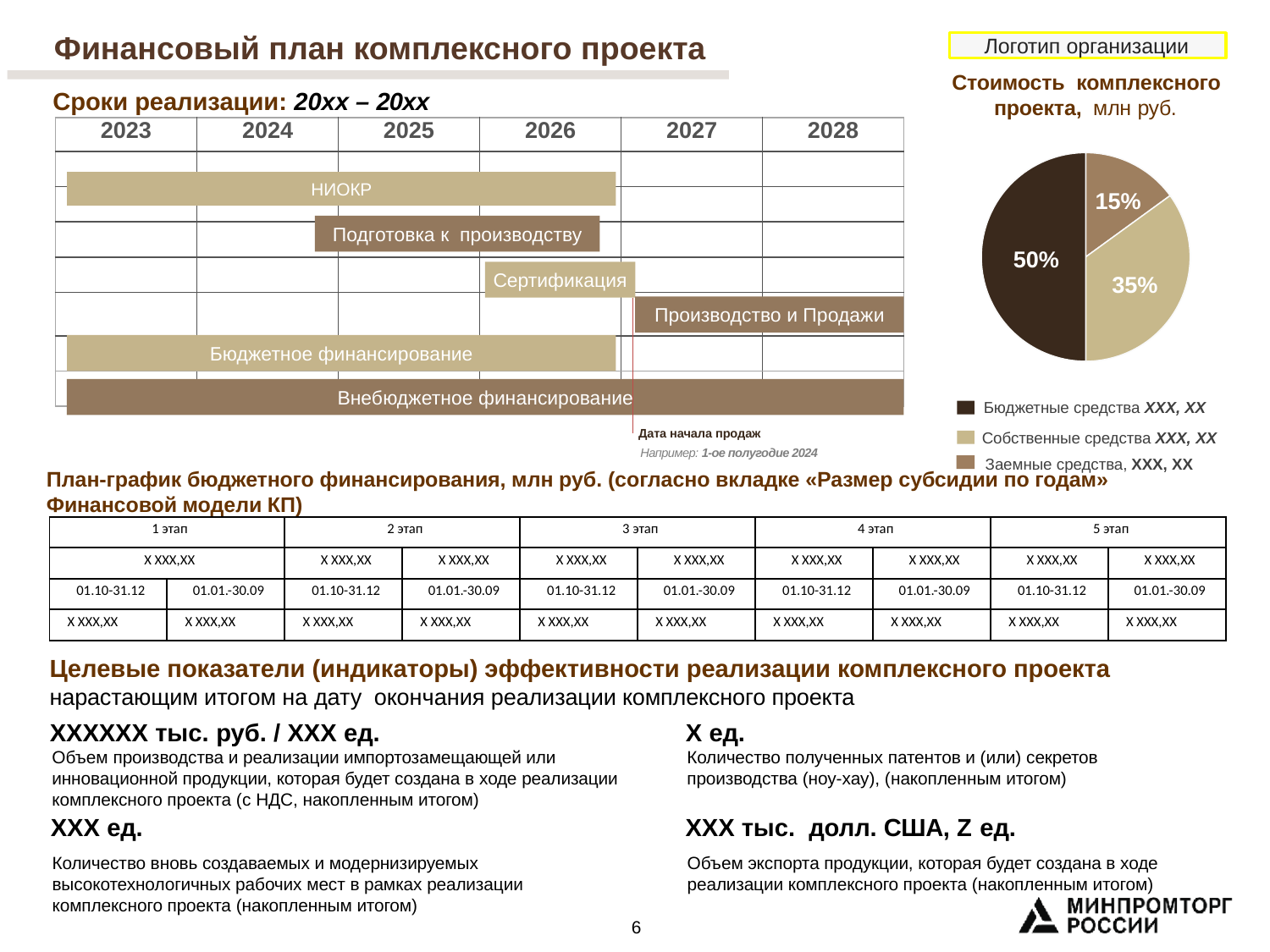
In the pie chart «Стоимость комплексного проекта», by how many percentage points does the Бюджетные средства slice exceed the Собственные средства slice? 15 percentage points In the pie chart «Стоимость комплексного проекта», what share is shown for Собственные средства? 35% How many entries does the legend of the pie chart «Стоимость комплексного проекта» list? 3 How many slices does the pie chart «Стоимость комплексного проекта» have? 3 In the pie chart «Стоимость комплексного проекта», what share is shown for Бюджетные средства? 50% In the pie chart «Стоимость комплексного проекта», which legend category is shown in the darkest brown colour? Бюджетные средства In the pie chart «Стоимость комплексного проекта», which category has the smallest slice? Заемные средства In what units is the pie chart «Стоимость комплексного проекта» expressed, according to its title? млн руб. In the pie chart «Стоимость комплексного проекта», which category has the largest slice? Бюджетные средства What kind of chart is shown under the heading «Стоимость комплексного проекта»? pie chart In the pie chart «Стоимость комплексного проекта», which slice is larger: Собственные средства or Заемные средства? Собственные средства In the pie chart «Стоимость комплексного проекта», what share is shown for Заемные средства? 15%